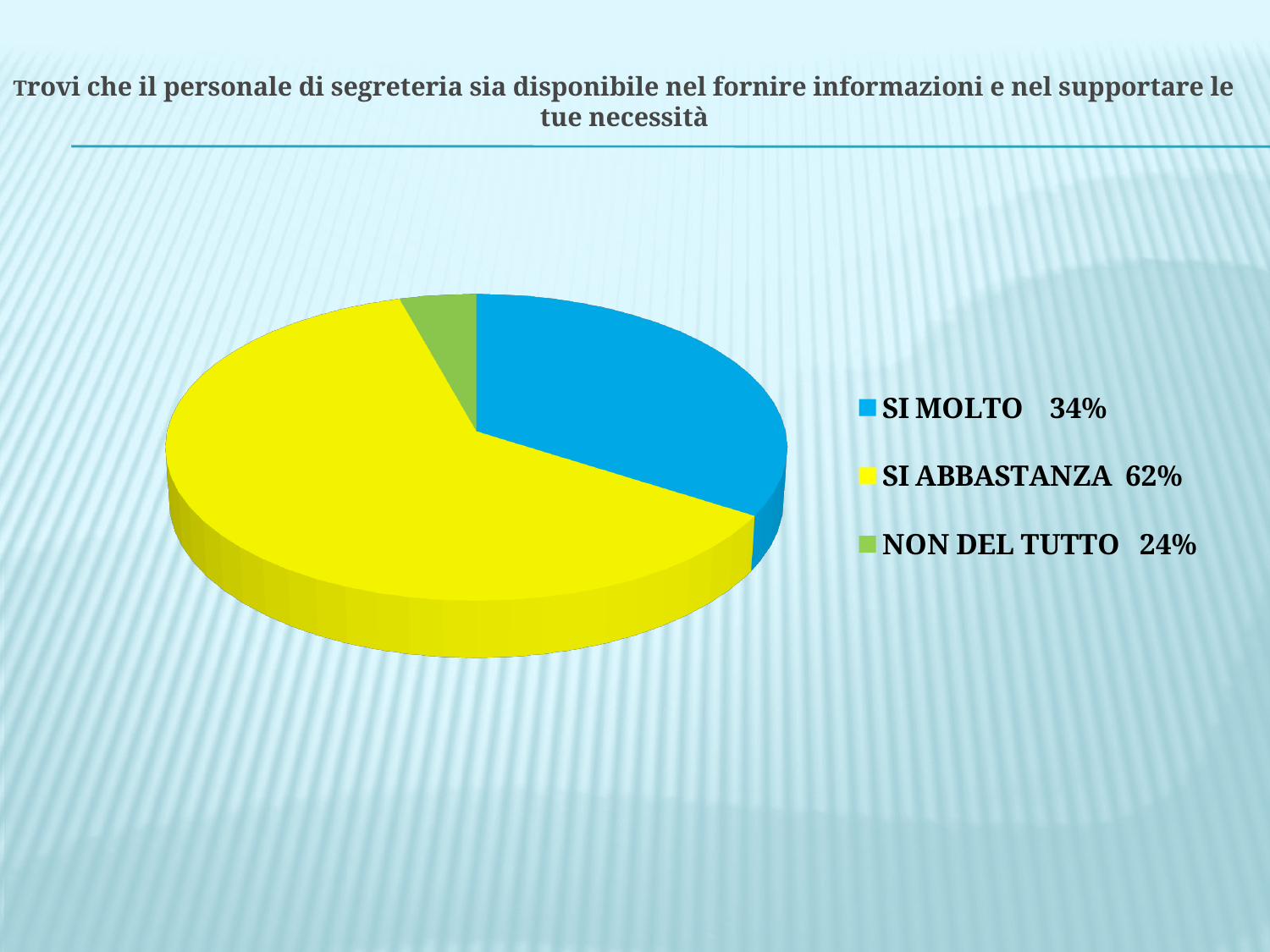
What colour is the SI ABBASTANZA slice? yellow Which is larger, the share for SI MOLTO or the share for NON DEL TUTTO? SI MOLTO What is the difference in percentage points between SI ABBASTANZA and SI MOLTO? 28 What percentage is shown for SI ABBASTANZA? 62% How many categories does the pie chart show? 3 What percentage is shown for SI MOLTO? 34% According to the legend, what percentage is shown for NON DEL TUTTO? 24% What colour is the SI MOLTO slice? blue Which category has the smallest share of the pie? NON DEL TUTTO What kind of chart is shown on the slide? pie chart Which category has the largest share of the pie? SI ABBASTANZA